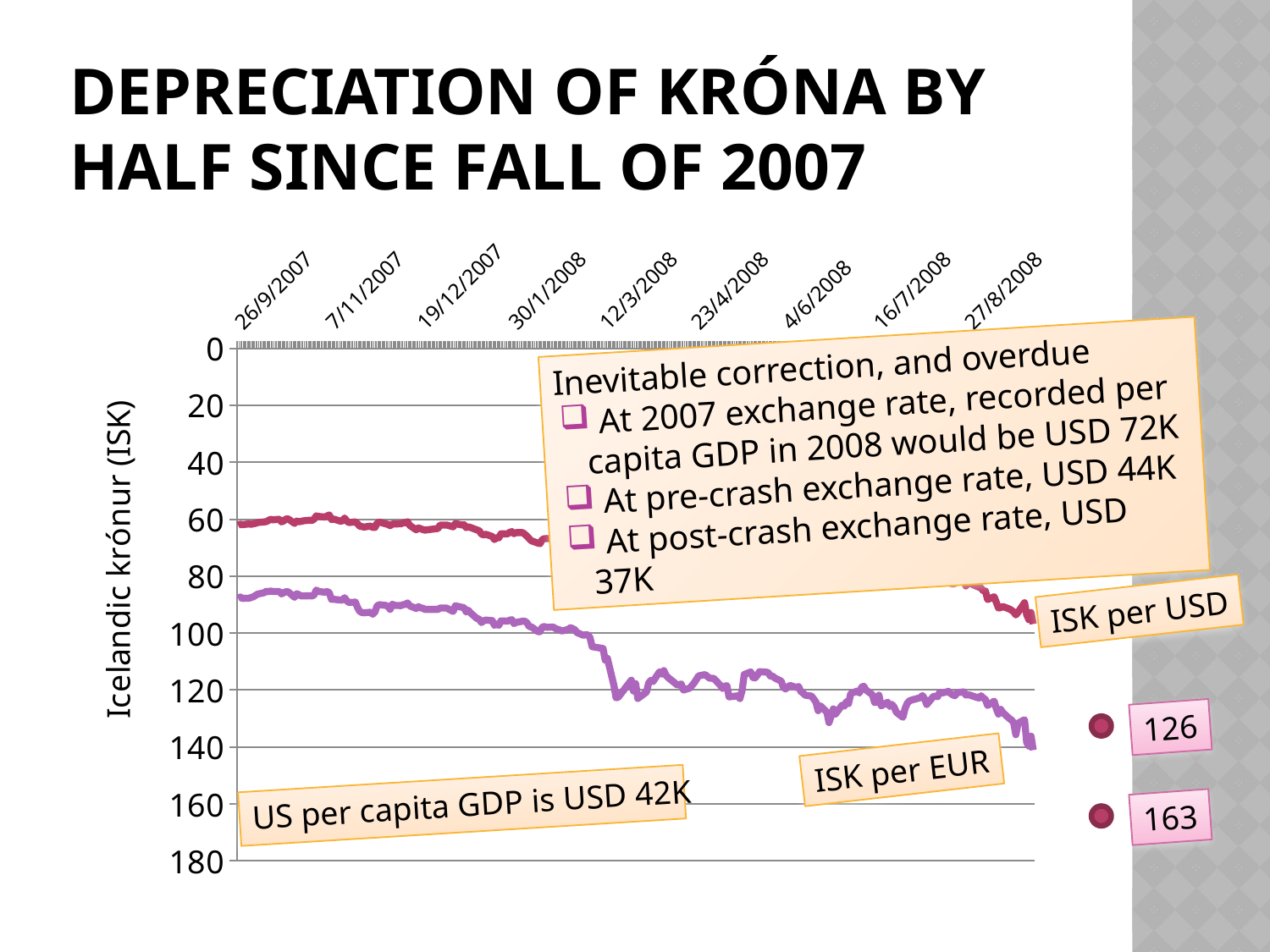
What kind of chart is shown on the slide? line chart What is the last date shown on the x axis of the chart? 27/8/2008 Is the ISK per USD value at 26/9/2007 greater or less than 80? less What is the label on the vertical axis of the chart? Icelandic krónur (ISK) What is the first date shown on the x axis of the chart? 26/9/2007 Is the ISK per EUR value at 26/9/2007 greater or less than 100? less How many data series are plotted on the chart? 2 What are the names of the two series plotted on the chart? ISK per USD and ISK per EUR Which series has the higher values throughout the chart, ISK per USD or ISK per EUR? ISK per EUR Do the ISK per EUR values rise or fall from 26/9/2007 to 27/8/2008? rise How many date labels are shown along the x axis of the chart? 9